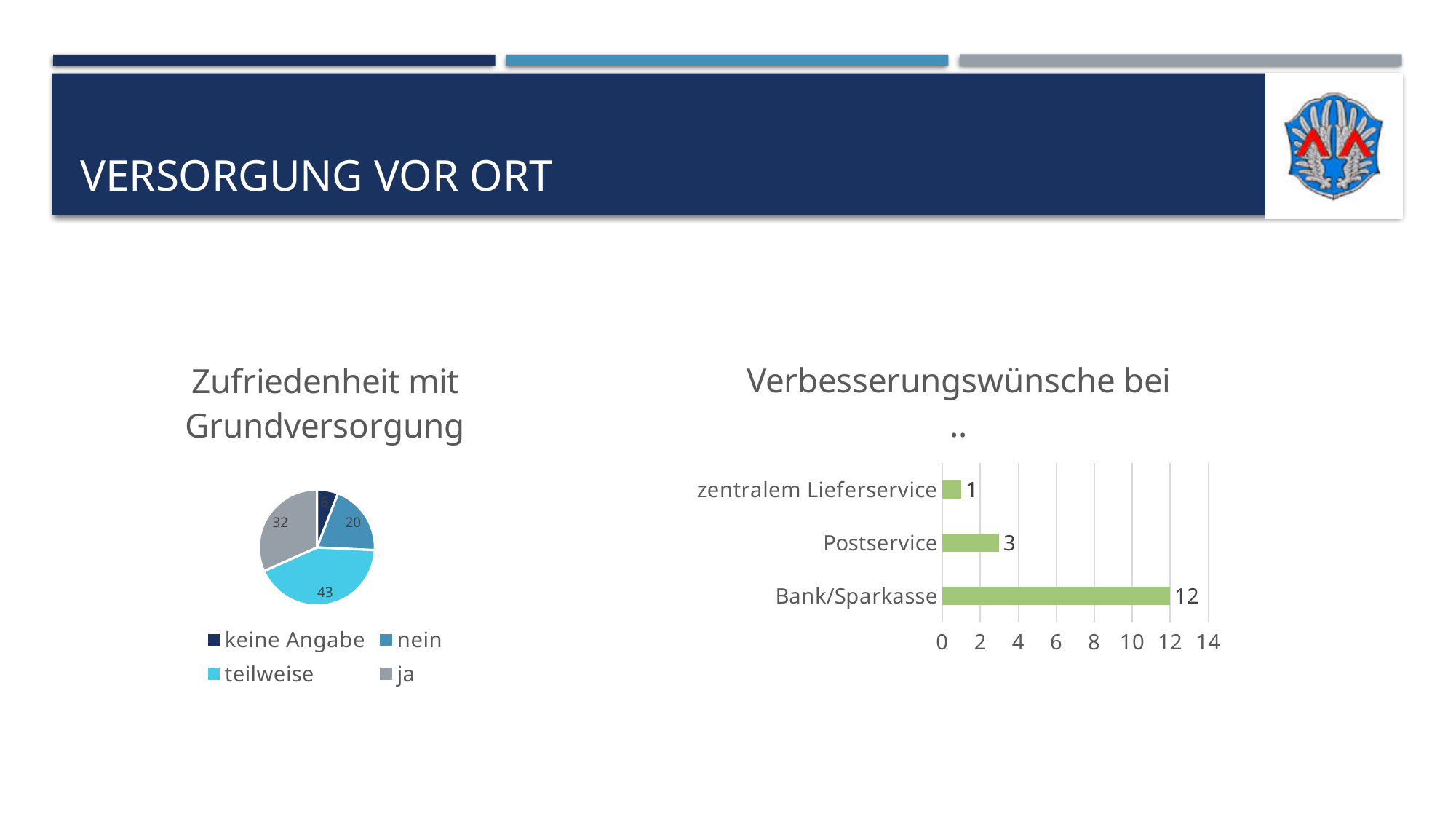
In the chart titled "Verbesserungswünsche bei ..", how many categories are shown? 3 In the chart titled "Verbesserungswünsche bei ..", which category has the highest value? Bank/Sparkasse In the chart titled "Verbesserungswünsche bei ..", what is the value for Bank/Sparkasse? 12 In the chart titled "Verbesserungswünsche bei ..", which category has the lowest value? zentralem Lieferservice In the chart titled "Verbesserungswünsche bei ..", what is the difference between the values for Bank/Sparkasse and Postservice? 9 In the pie chart titled "Zufriedenheit mit Grundversorgung", what is the value for teilweise? 43 In the chart titled "Verbesserungswünsche bei ..", what is the value for zentralem Lieferservice? 1 In the pie chart titled "Zufriedenheit mit Grundversorgung", what is the value for nein? 20 In the chart titled "Verbesserungswünsche bei ..", what is the value for Postservice? 3 In the pie chart titled "Zufriedenheit mit Grundversorgung", which is larger, ja or nein? ja What kind of chart is the chart titled "Verbesserungswünsche bei .."? bar chart How many entries does the legend of the pie chart titled "Zufriedenheit mit Grundversorgung" list? 4